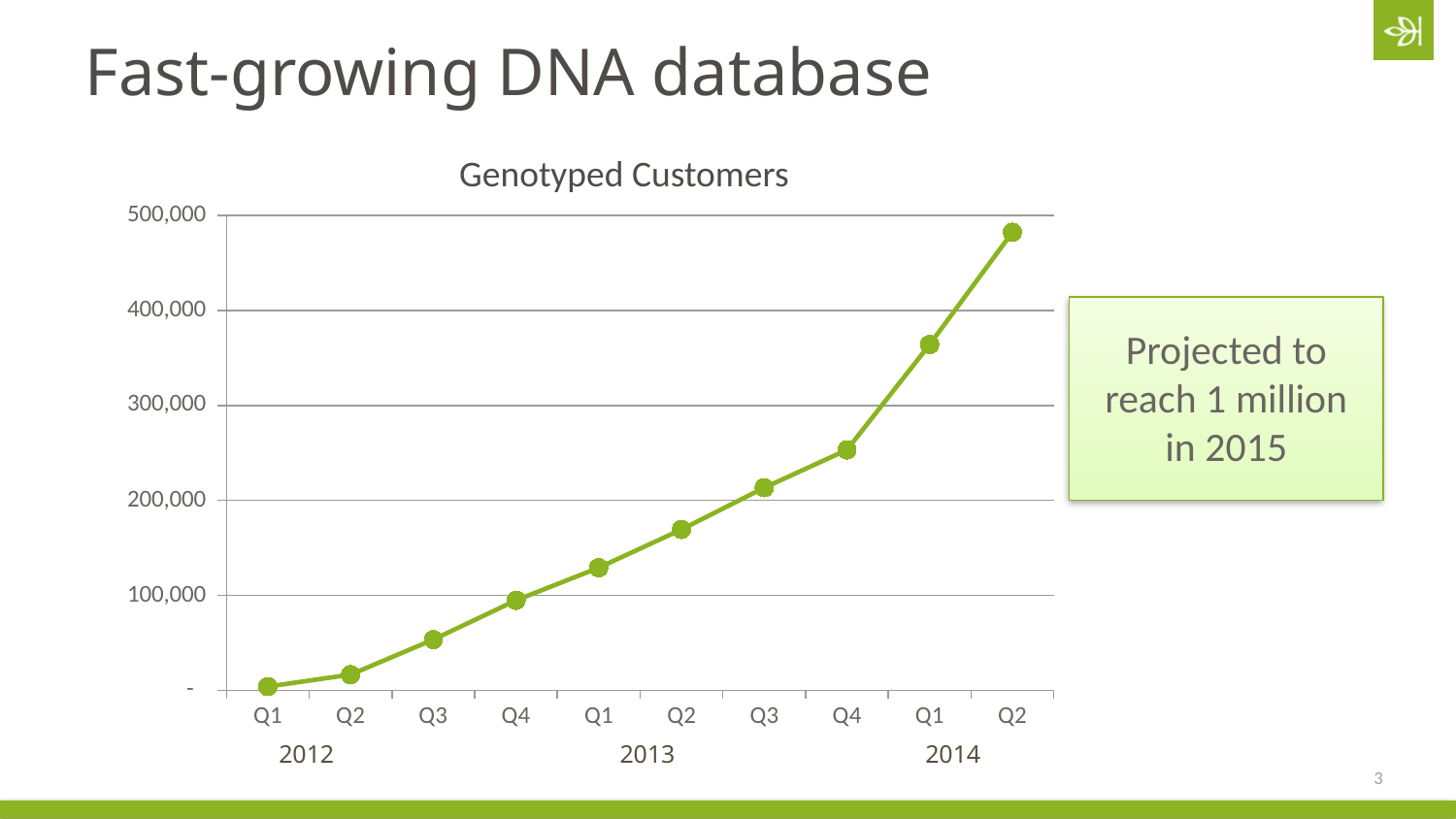
Which quarter has the lowest number of genotyped customers? Q1 2012 Is the value for Q4 2013 greater or less than 200,000? greater Which quarter has the highest number of genotyped customers? Q2 2014 Do the values rise or fall from Q1 2012 to Q2 2014? rise How many data points are plotted on the line? 10 According to the text box next to the chart, what is the database projected to reach in 2015? 1 million What is the title of the chart? Genotyped Customers Is the value for Q3 2012 greater or less than 100,000? less What kind of chart is shown on the slide? line chart Which is larger, the value for Q1 2014 or the value for Q4 2013? Q1 2014 Is the value for Q1 2014 greater or less than 400,000? less